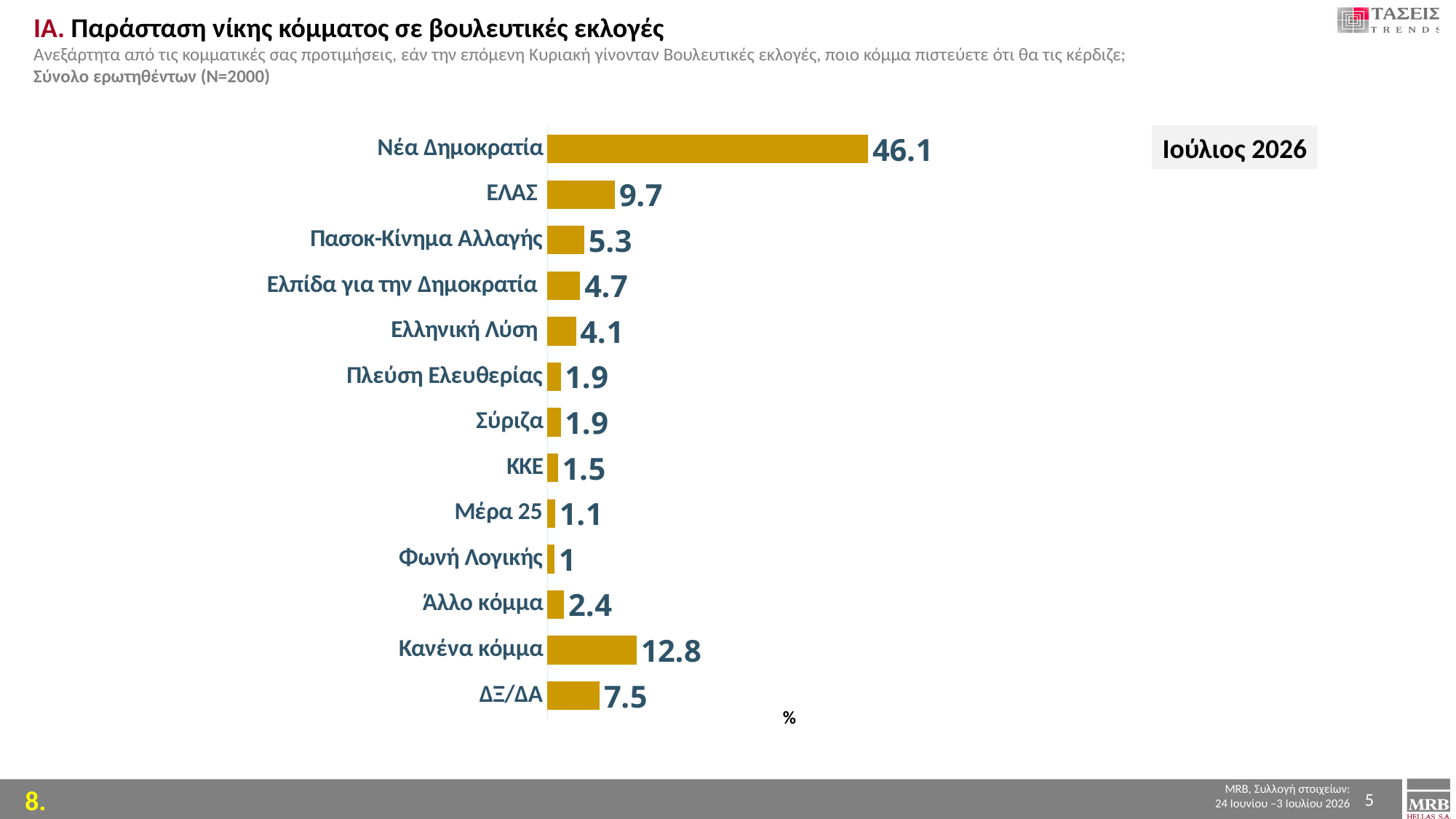
What date label is shown in the box to the right of the chart? Ιούλιος 2026 What value is shown for Νέα Δημοκρατία? 46.1 Which is larger, the value for Πασοκ-Κίνημα Αλλαγής or the value for Ελπίδα για την Δημοκρατία? Πασοκ-Κίνημα Αλλαγής What value is shown for Κανένα κόμμα? 12.8 What is the difference between the values for Νέα Δημοκρατία and ΕΛΑΣ? 36.4 Which category has the lowest value? Φωνή Λογικής How many categories are shown in the chart? 13 Which category has the highest value? Νέα Δημοκρατία What value is shown for Ελληνική Λύση? 4.1 What value is shown for ΔΞ/ΔΑ? 7.5 What kind of chart is shown on the slide? Bar chart What is the difference between the values for Κανένα κόμμα and ΔΞ/ΔΑ? 5.3